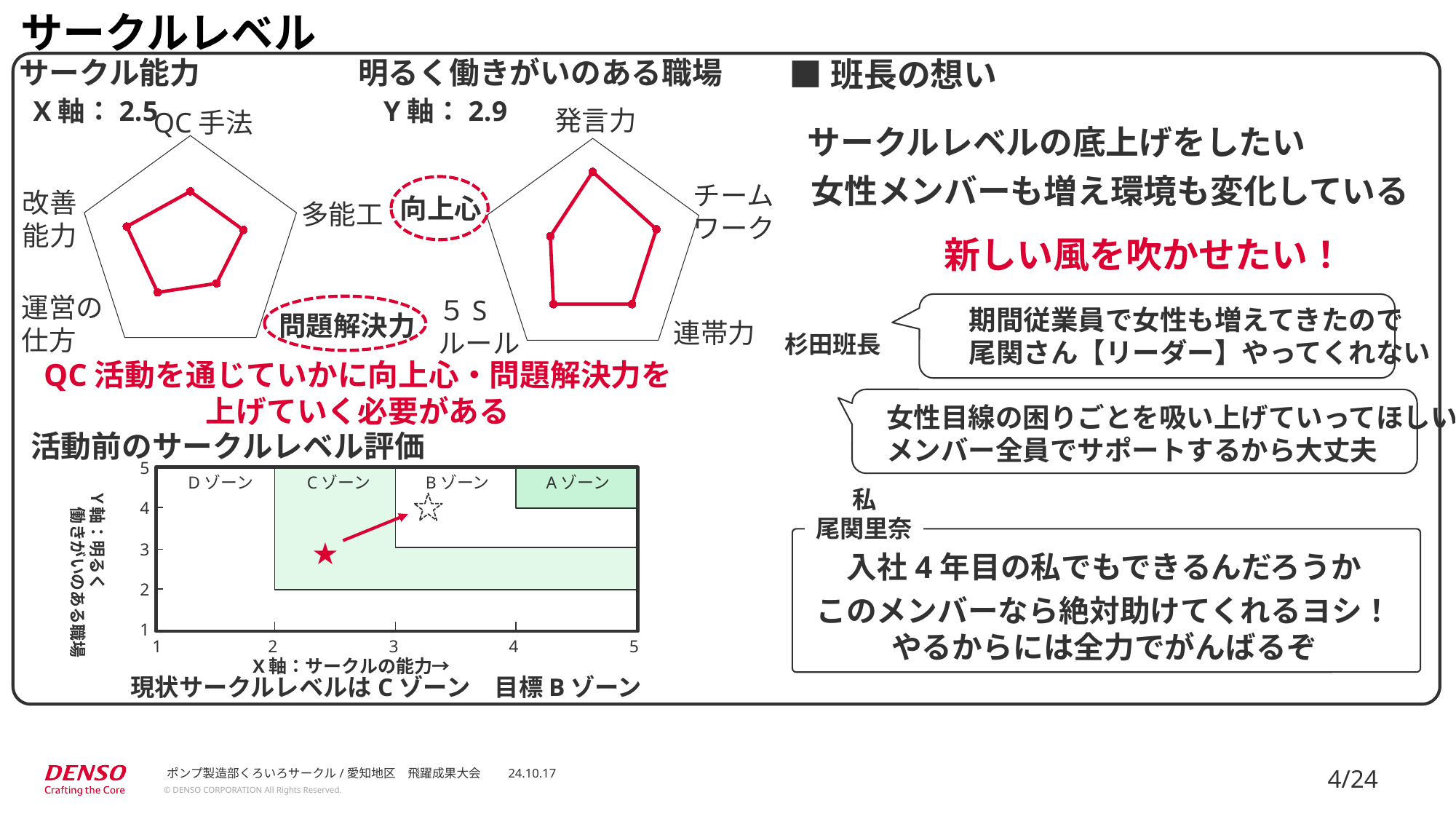
In the 明るく働きがいのある職場 radar chart, which is larger, 発言力 or 向上心? 発言力 What X軸 value is printed for the サークル能力 radar chart? 2.5 In the 明るく働きがいのある職場 radar chart, which axis has the lowest value? 向上心 In the 活動前のサークルレベル評価 chart, how many zones are labelled? 4 How many axes (categories) does the サークル能力 radar chart have? 5 How many axes (categories) does the 明るく働きがいのある職場 radar chart have? 5 What kind of chart is the サークル能力 chart? radar chart What Y軸 value is printed for the 明るく働きがいのある職場 radar chart? 2.9 In the 活動前のサークルレベル評価 chart, what is the label of the X axis? X 軸：サークルの能力→ In the 活動前のサークルレベル評価 chart, is the X-axis value of the current level (filled star) greater or less than 3? less In the 活動前のサークルレベル評価 chart, which zone is the target (hollow star) in? B ゾーン In the 活動前のサークルレベル評価 chart, which zone is the current circle level (filled star) in? C ゾーン